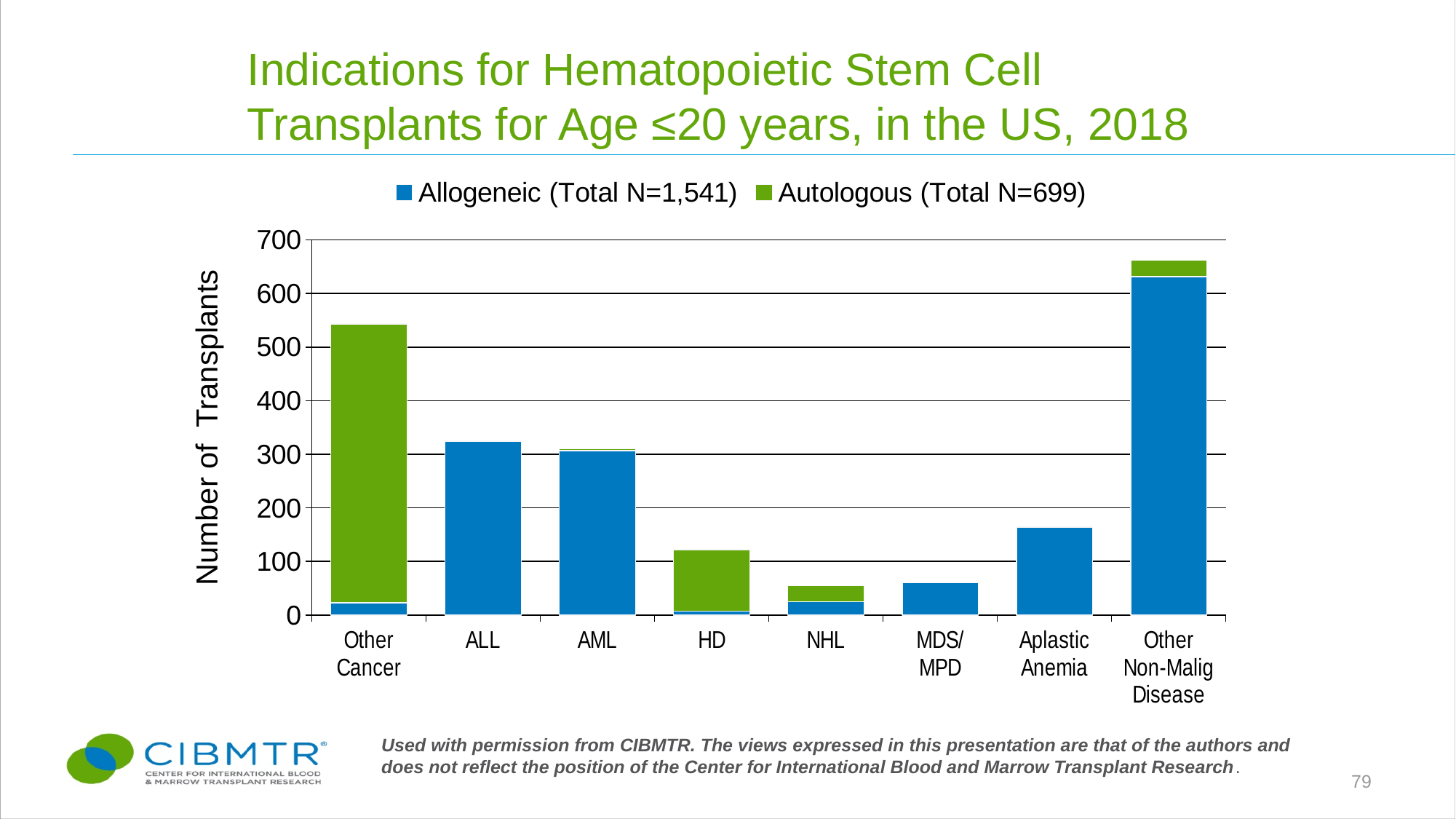
Is the total bar for Other Cancer greater or less than 500? greater What is the label of the y axis? Number of Transplants Is the total bar for HD greater or less than 100? greater Is the total bar for Aplastic Anemia greater or less than 200? less What total N is given for Allogeneic transplants in the legend? 1,541 Which category has the largest Autologous (green) segment? Other Cancer How many series does the legend list? 2 What kind of chart is shown on the slide? Stacked bar chart How many indication categories are shown on the x axis? 8 Which category has the tallest total bar? Other Non-Malig Disease Which has a taller total bar, Other Cancer or ALL? Other Cancer